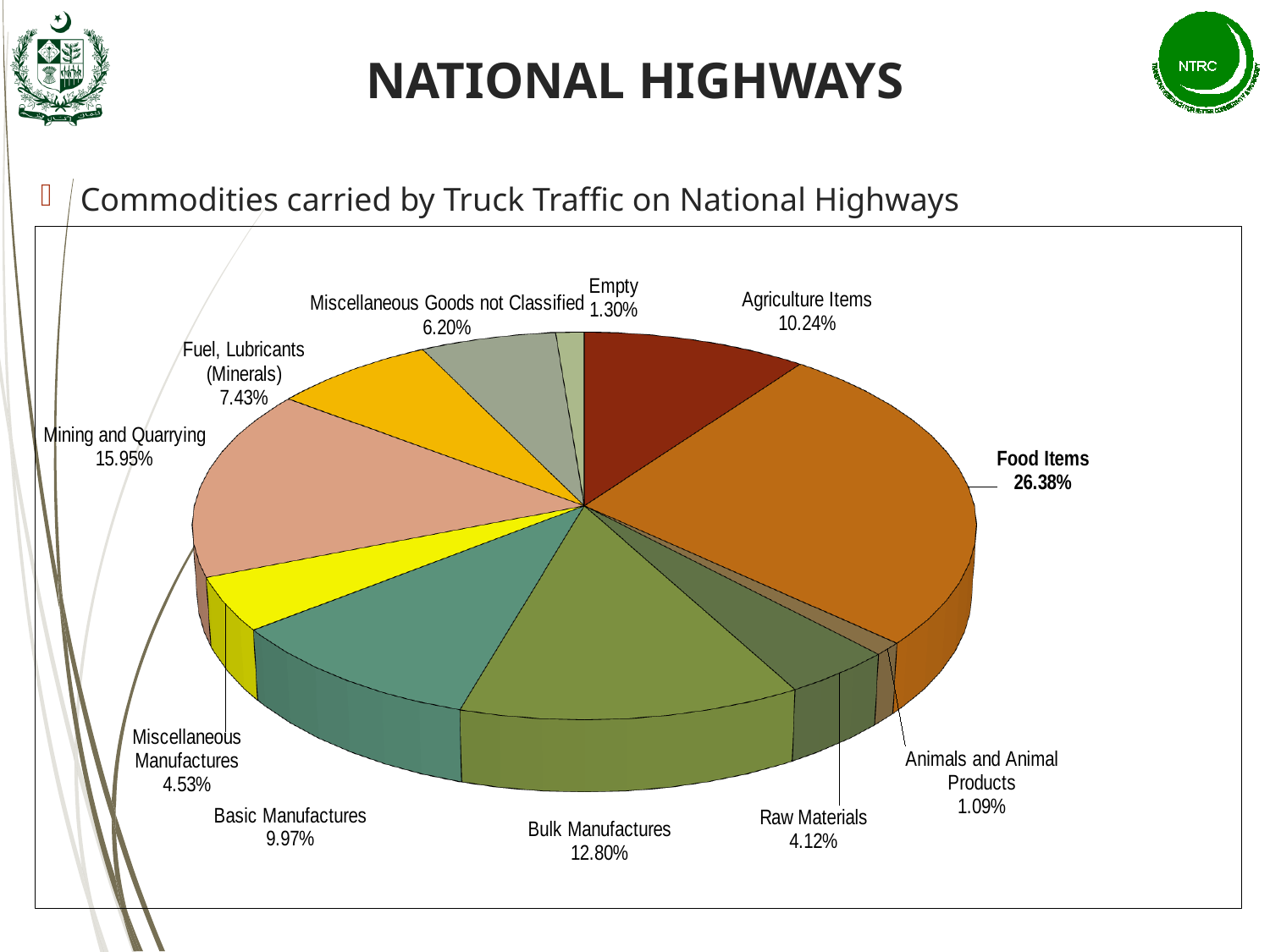
Which has a larger share, Basic Manufactures or Fuel, Lubricants (Minerals)? Basic Manufactures Which commodity category has the largest share of the pie? Food Items What is the title of the chart? Commodities carried by Truck Traffic on National Highways What percentage is shown for Animals and Animal Products? 1.09% What percentage is shown for Mining and Quarrying? 15.95% What share of truck traffic commodities is Food Items? 26.38% What is the difference in percentage points between Miscellaneous Goods not Classified and Empty? 4.90 Which commodity category has the smallest share of the pie? Animals and Animal Products What kind of chart is shown on the slide? Pie chart What percentage is shown for Bulk Manufactures? 12.80% How many commodity categories are shown in the pie chart? 11 What is the difference in percentage points between Food Items and Agriculture Items? 16.14